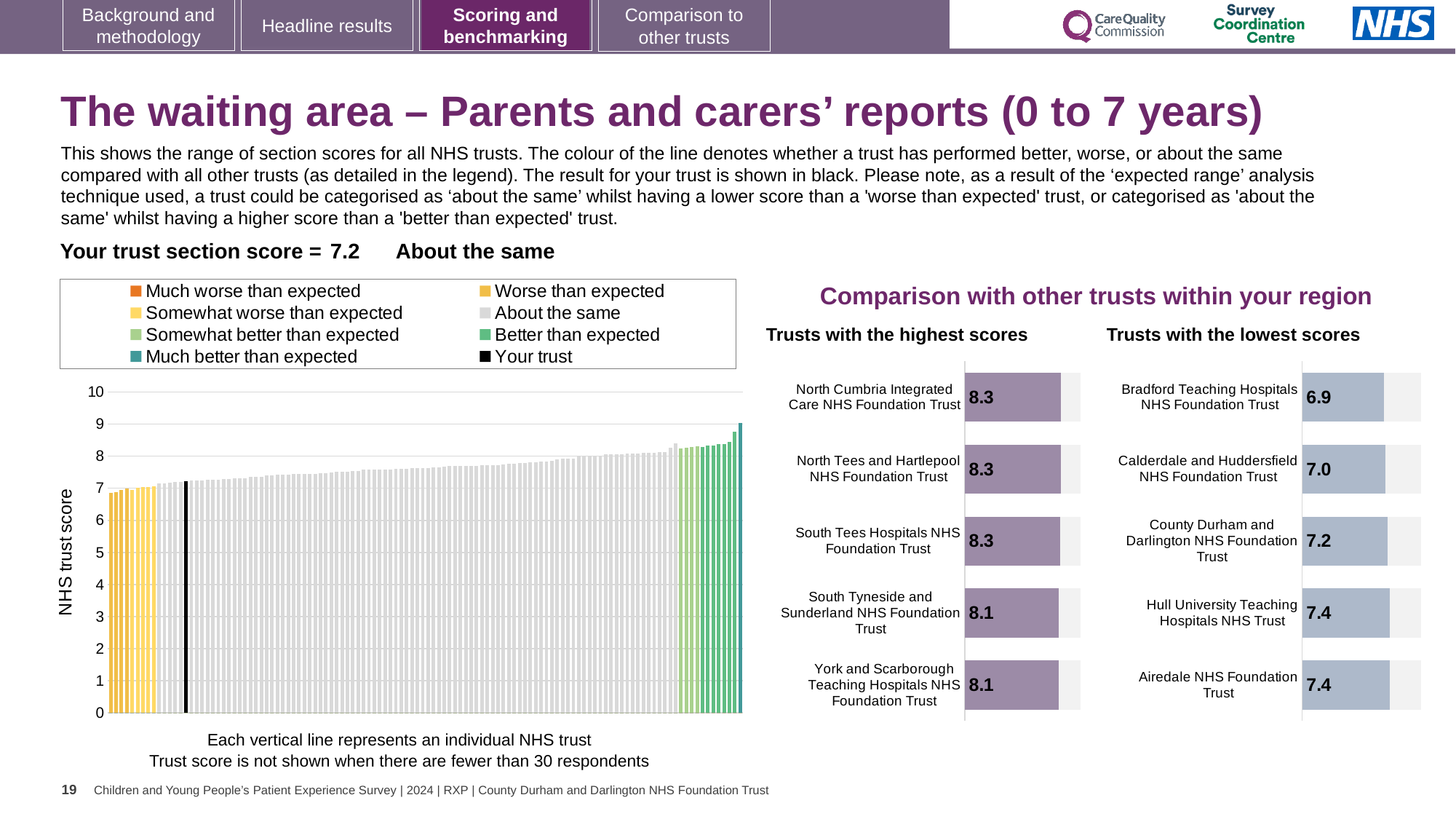
How many entries does the legend of the large chart on the left list? 8 In the 'Trusts with the lowest scores' chart, which has the higher score: Calderdale and Huddersfield NHS Foundation Trust or Hull University Teaching Hospitals NHS Trust? Hull University Teaching Hospitals NHS Trust In the 'Trusts with the highest scores' chart, what is the score for North Cumbria Integrated Care NHS Foundation Trust? 8.3 How many trusts are shown in the 'Trusts with the highest scores' chart? 5 In the 'Trusts with the lowest scores' chart, which trust has the lowest score? Bradford Teaching Hospitals NHS Foundation Trust What kind of chart is the large chart on the left showing all NHS trusts? bar chart In the 'Trusts with the lowest scores' chart, what is the score for Calderdale and Huddersfield NHS Foundation Trust? 7.0 In the 'Trusts with the highest scores' chart, what is the difference between the scores of South Tees Hospitals NHS Foundation Trust and South Tyneside and Sunderland NHS Foundation Trust? 0.2 In the large chart on the left showing all NHS trusts, is the value for the black 'Your trust' bar greater or less than 7? greater In the 'Trusts with the lowest scores' chart, what is the difference between the scores of Airedale NHS Foundation Trust and Bradford Teaching Hospitals NHS Foundation Trust? 0.5 In the 'Trusts with the highest scores' chart, what is the score for York and Scarborough Teaching Hospitals NHS Foundation Trust? 8.1 In the large chart on the left showing all NHS trusts, do the bar values rise or fall from left to right? rise